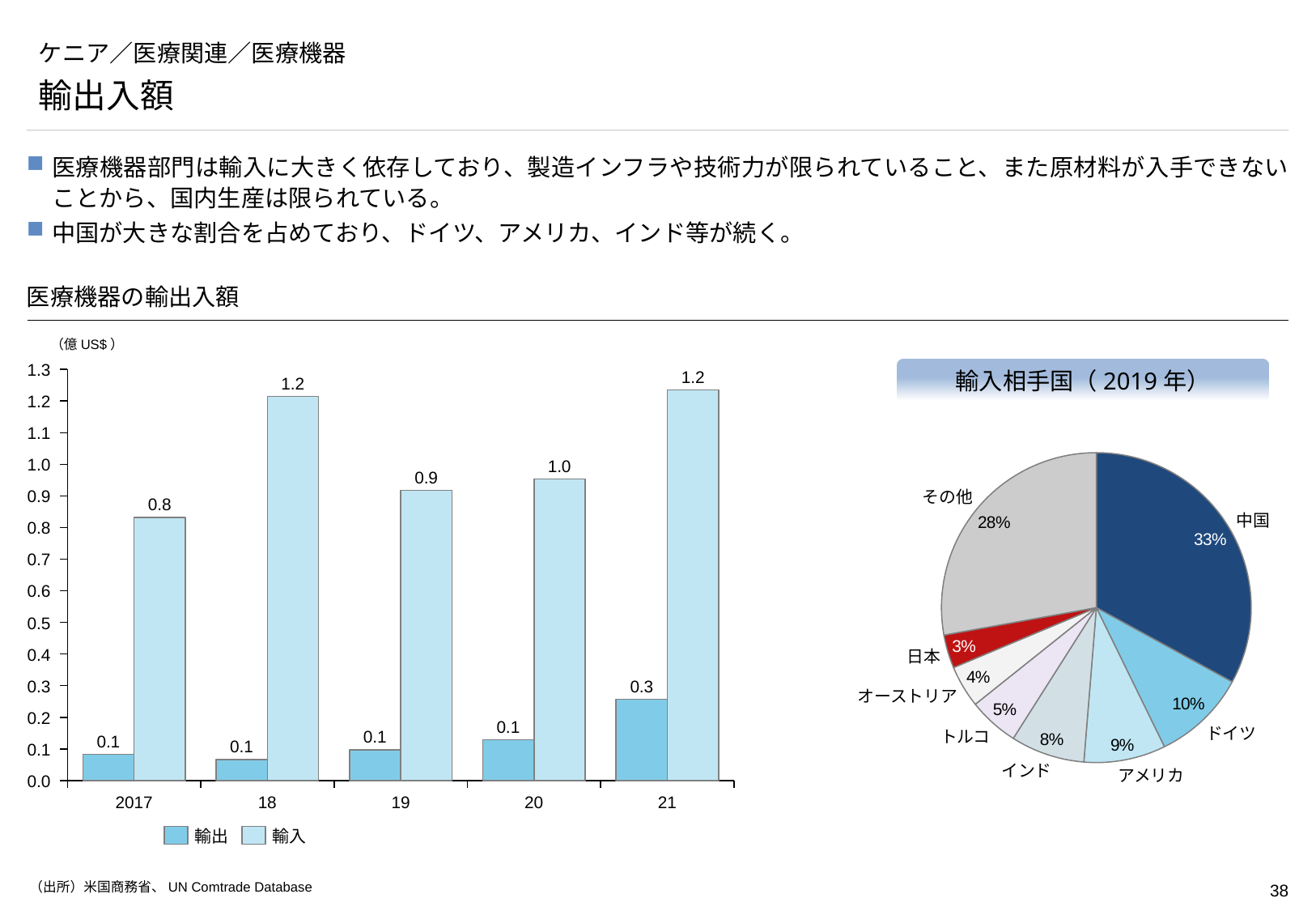
In the pie chart 輸入相手国（2019年）, what share does 中国 have? 33% In the bar chart 医療機器の輸出入額, what is the value of 輸入 in 19? 0.9 What kind of chart is 輸入相手国（2019年）? pie chart In the bar chart 医療機器の輸出入額, how many series does the legend list? 2 In the pie chart 輸入相手国（2019年）, what is the share for 日本? 3% In the pie chart 輸入相手国（2019年）, which of ドイツ and アメリカ has the larger share? ドイツ In the bar chart 医療機器の輸出入額, which year has the lowest 輸入 value? 2017 In the bar chart 医療機器の輸出入額, is the 輸入 value for 18 greater or less than 1.0? greater In the bar chart 医療機器の輸出入額, what is the value of 輸出 in 21? 0.3 In the bar chart 医療機器の輸出入額, how many years are shown on the x axis? 5 In the bar chart 医療機器の輸出入額, what is the difference between 輸入 and 輸出 in 20? 0.9 In the bar chart 医療機器の輸出入額, what is the value of 輸入 in 2017? 0.8